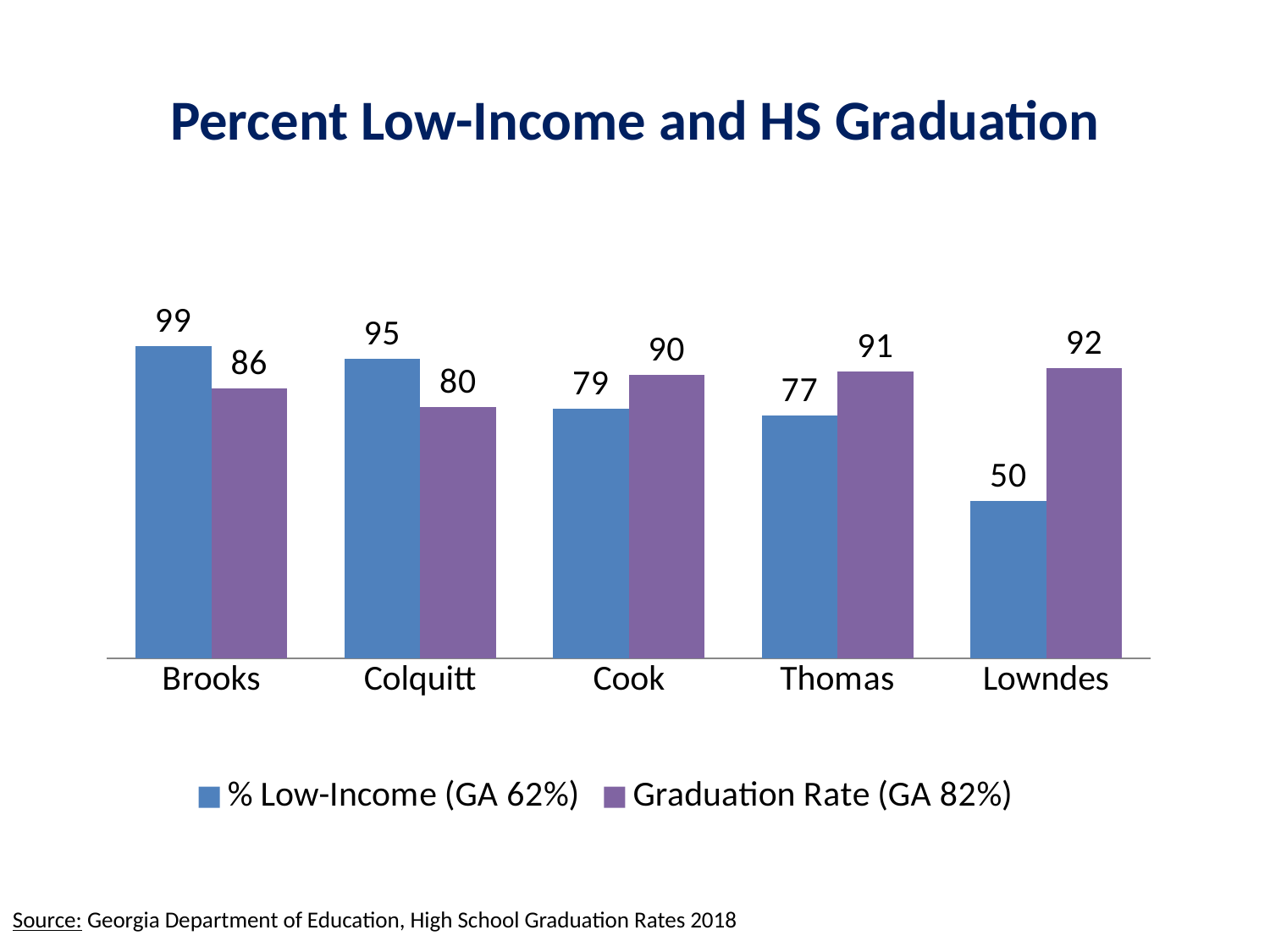
What is the difference between the % Low-Income and Graduation Rate values for Lowndes? 42 What is the % Low-Income value for Brooks? 99 Which county has the lowest % Low-Income value? Lowndes What is the title of the chart? Percent Low-Income and HS Graduation Which is larger for Cook: the % Low-Income value or the Graduation Rate? Graduation Rate Which county has the lowest Graduation Rate? Colquitt Which county has the highest Graduation Rate? Lowndes How many counties are shown on the x axis? 5 What is the Graduation Rate for Lowndes? 92 What kind of chart is shown on the slide? Bar chart How many series does the legend list? 2 What is the Graduation Rate for Colquitt? 80